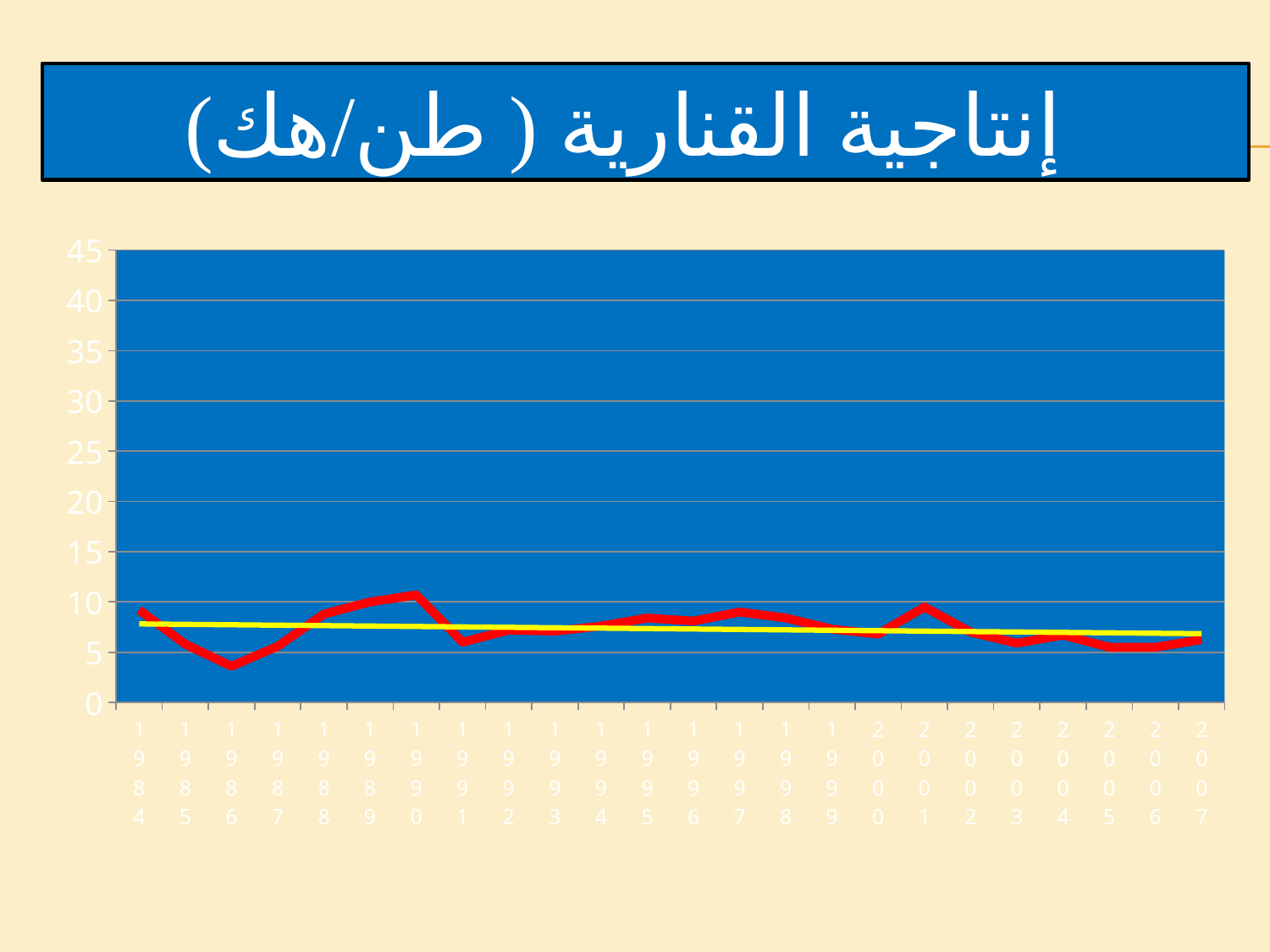
Which year has the lowest value on the red line? 1986 Which year has the highest value on the red line? 1990 Does the yellow trend line rise or fall from 1984 to 2007? fall What kind of chart is shown on the slide? line chart Is the value for 1986 greater or less than 5? less Is the value for 1984 greater or less than 15? less How many years are plotted along the x axis? 24 Is the value for 1990 greater or less than 5? greater What is the last year shown on the x axis? 2007 Which year has the larger value, 1986 or 1990? 1990 What is the first year shown on the x axis? 1984